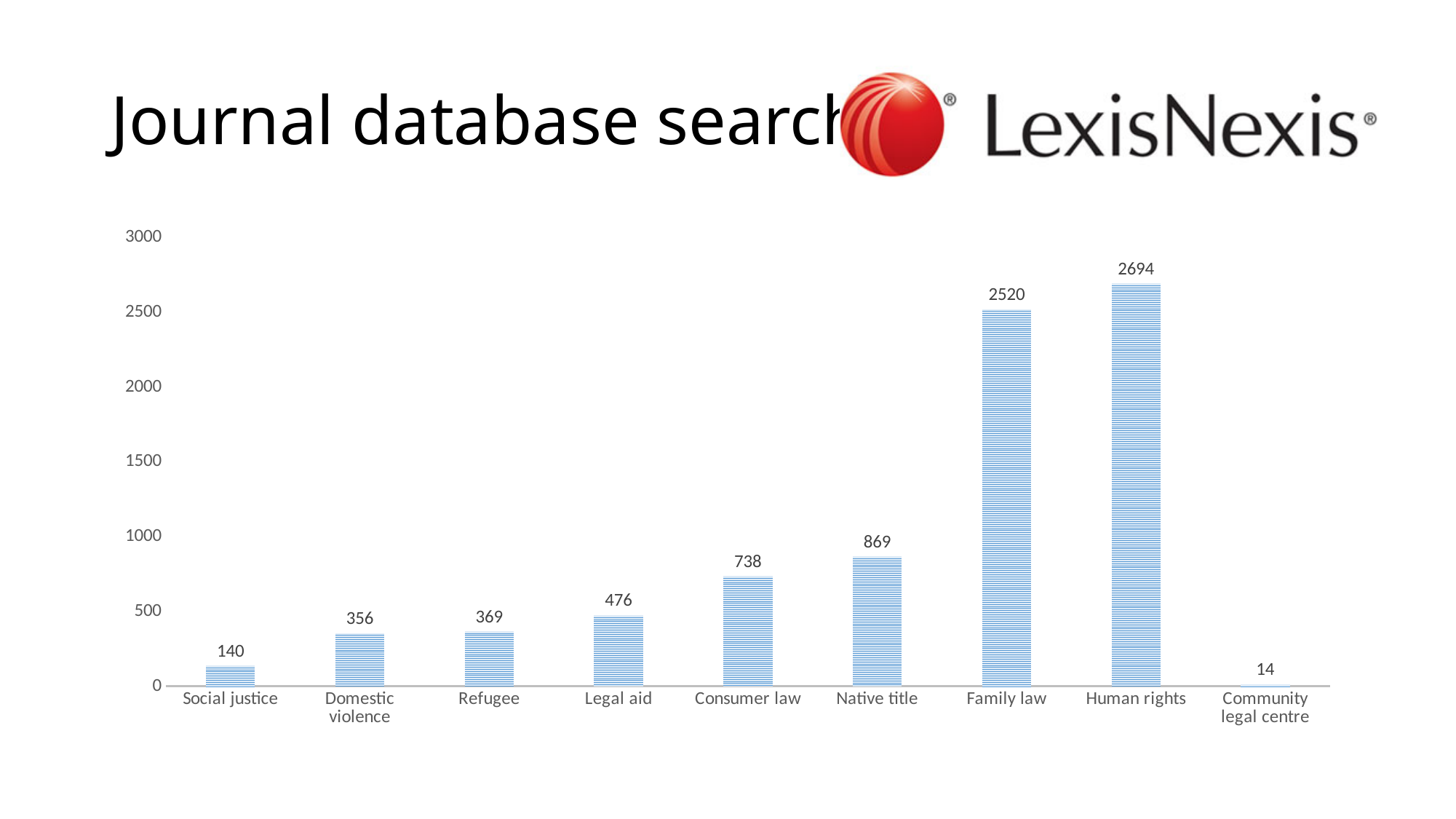
Which category has the highest value? Human rights What is the title of the slide? Journal database search What is the difference between the values for Human rights and Family law? 174 What is the difference between the values for Consumer law and Legal aid? 262 What is the value for Native title? 869 What is the value for Community legal centre? 14 What is the value for Human rights? 2694 Which is larger, the value for Refugee or the value for Domestic violence? Refugee Which category has the lowest value? Community legal centre What kind of chart is shown on the slide? bar chart How many categories are shown on the x axis? 9 Is the value for Native title greater or less than 1000? less